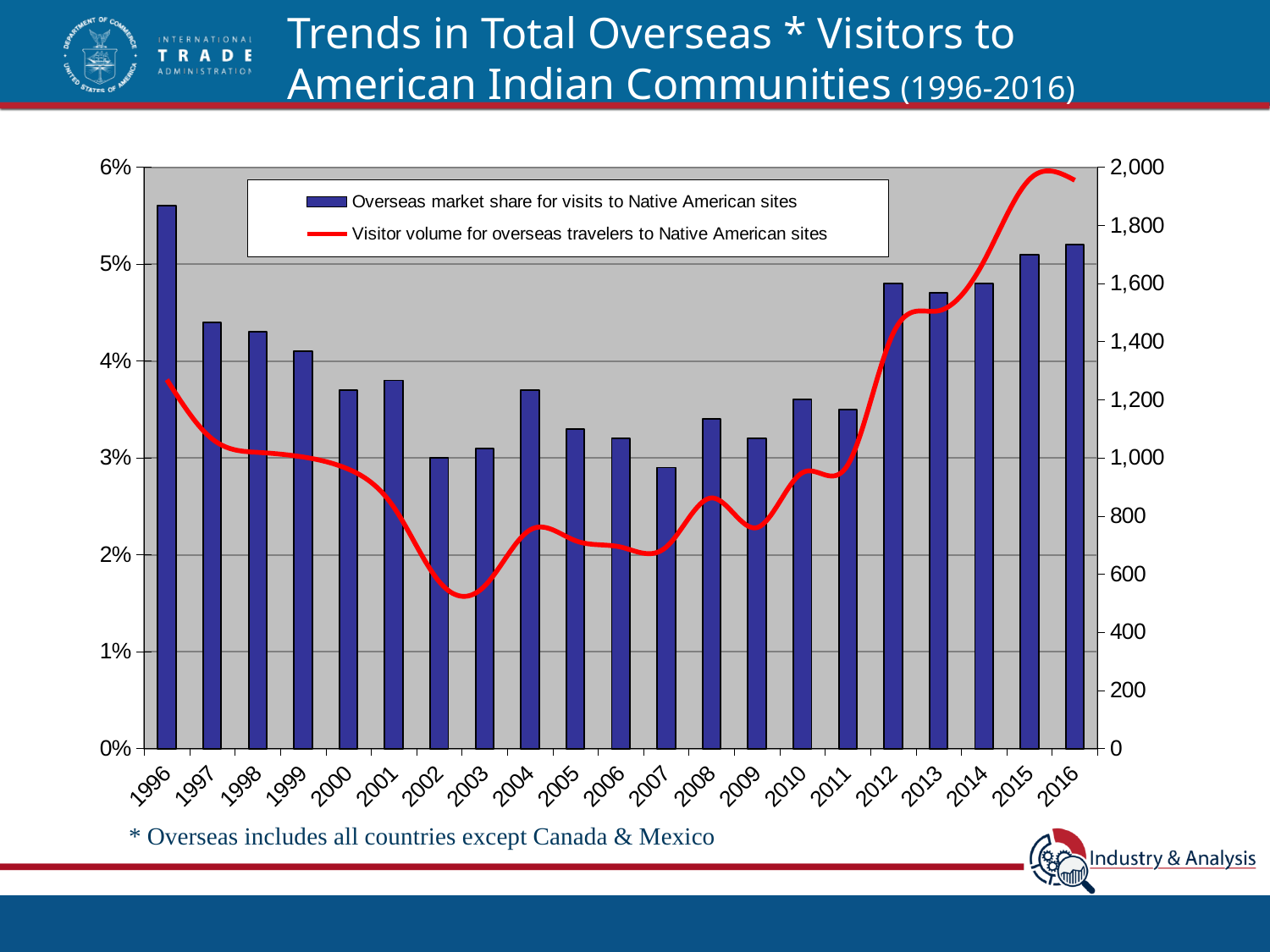
How many years are shown along the x axis? 21 Does the visitor volume for overseas travelers rise or fall from 2011 to 2015? rise How many series does the legend list? 2 Is the visitor volume for overseas travelers in 2003 greater or less than 600? less What kind of chart is shown on the slide? A combination bar and line chart Is the visitor volume for overseas travelers in 2016 greater or less than 1,800? greater Which year has the highest overseas market share for visits to Native American sites? 1996 Is the overseas market share for 2012 greater or less than 4%? greater What colour is the line for visitor volume for overseas travelers to Native American sites? Red Which year has the larger overseas market share, 2007 or 2012? 2012